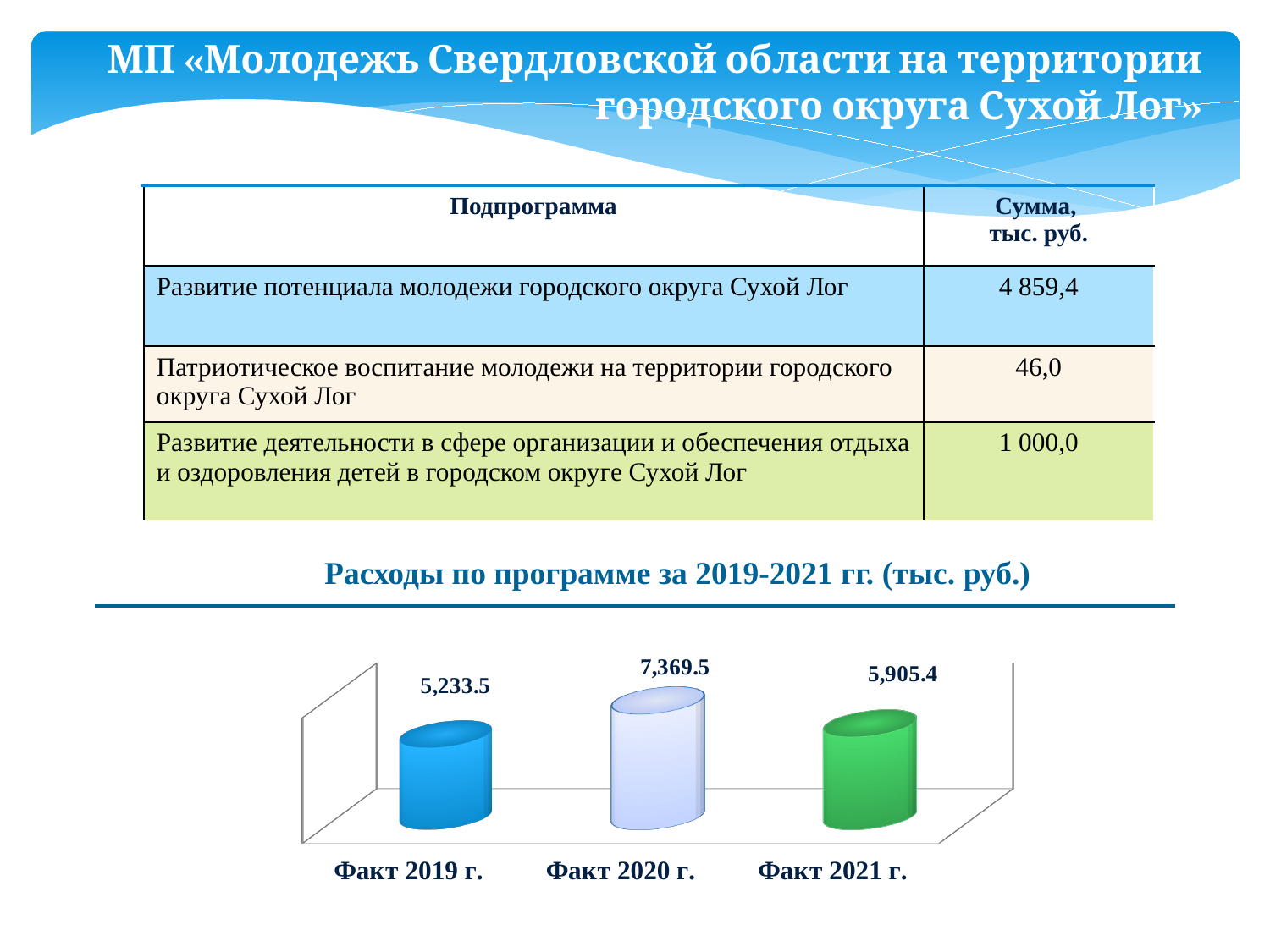
What is the value for Факт 2020 г.? 7,369.5 What kind of chart is shown on the slide? Bar chart How many categories are shown in the chart? 3 Which is larger, the value for Факт 2021 г. or Факт 2019 г.? Факт 2021 г. Which category has the highest value? Факт 2020 г. Which category has the lowest value? Факт 2019 г. What is the value for Факт 2019 г.? 5,233.5 What is the value for Факт 2021 г.? 5,905.4 What is the title of the chart? Расходы по программе за 2019-2021 гг. (тыс. руб.) What is the difference between the values for Факт 2020 г. and Факт 2019 г.? 2,136.0 What is the difference between the values for Факт 2021 г. and Факт 2019 г.? 671.9 What is the difference between the values for Факт 2020 г. and Факт 2021 г.? 1,464.1